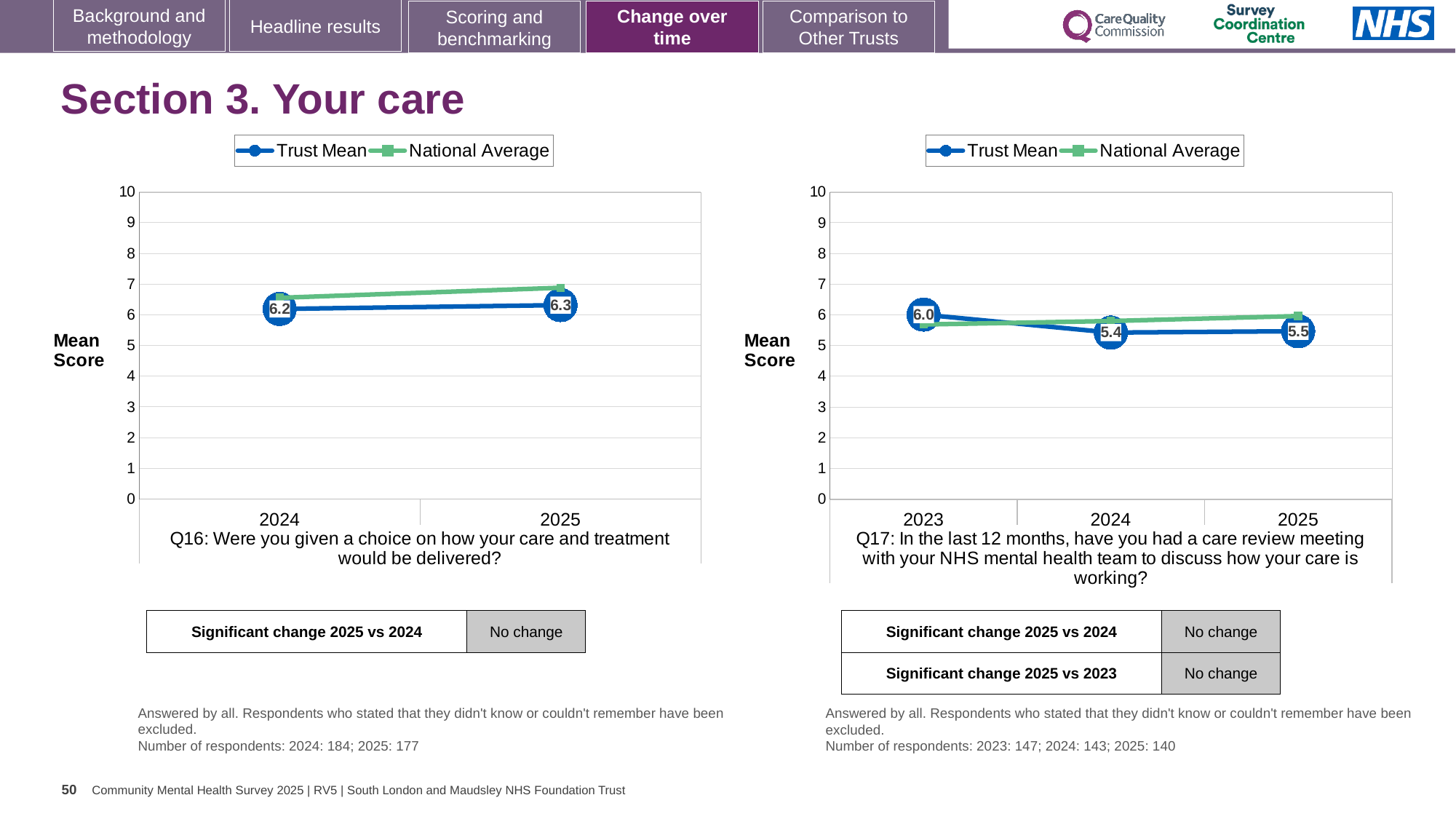
What type of chart is used for Q16 on the left? Line chart In the Q17 chart on the right, what is the Trust Mean score for 2023? 6.0 In the Q17 chart on the right, what is the Trust Mean score for 2024? 5.4 In the Q17 chart on the right, which year has the lowest Trust Mean score? 2024 In the Q17 chart on the right, what is the difference between the Trust Mean scores for 2023 and 2024? 0.6 How many series does the legend of the Q16 chart on the left list? 2 In the Q16 chart on the left, what is the Trust Mean score for 2025? 6.3 How many years are shown on the x axis of the Q17 chart on the right? 3 In the Q17 chart on the right, which year has the highest Trust Mean score? 2023 In the Q16 chart on the left, is the National Average value for 2025 greater or less than 6? greater In the Q16 chart on the left, what is the Trust Mean score for 2024? 6.2 In the Q16 chart on the left, is the Trust Mean score higher in 2024 or 2025? 2025